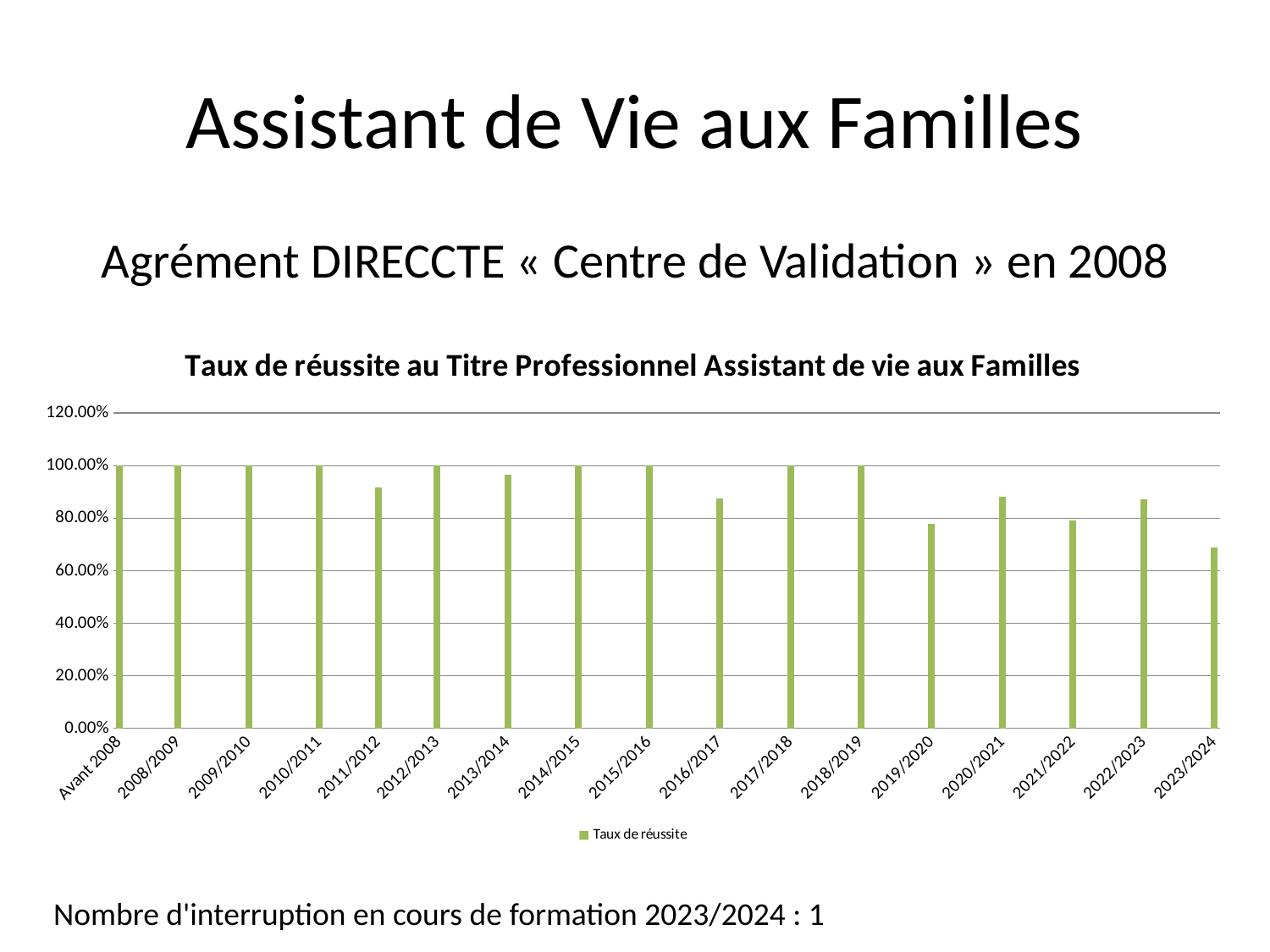
How many series does the legend list? 1 How many categories are shown on the x axis of the chart? 17 Is the value for 2019/2020 greater or less than 60.00%? greater Which is larger, the value for 2017/2018 or the value for 2019/2020? 2017/2018 Which is larger, the value for 2020/2021 or the value for 2023/2024? 2020/2021 Is the value for 2023/2024 greater or less than 80.00%? less Which category has the lowest Taux de réussite? 2023/2024 What is the Taux de réussite for 2008/2009? 100.00% What is the title of the chart? Taux de réussite au Titre Professionnel Assistant de vie aux Familles What kind of chart is shown on the slide? bar chart Is the value for 2016/2017 greater or less than 100.00%? less What is the Taux de réussite for 2018/2019? 100.00%